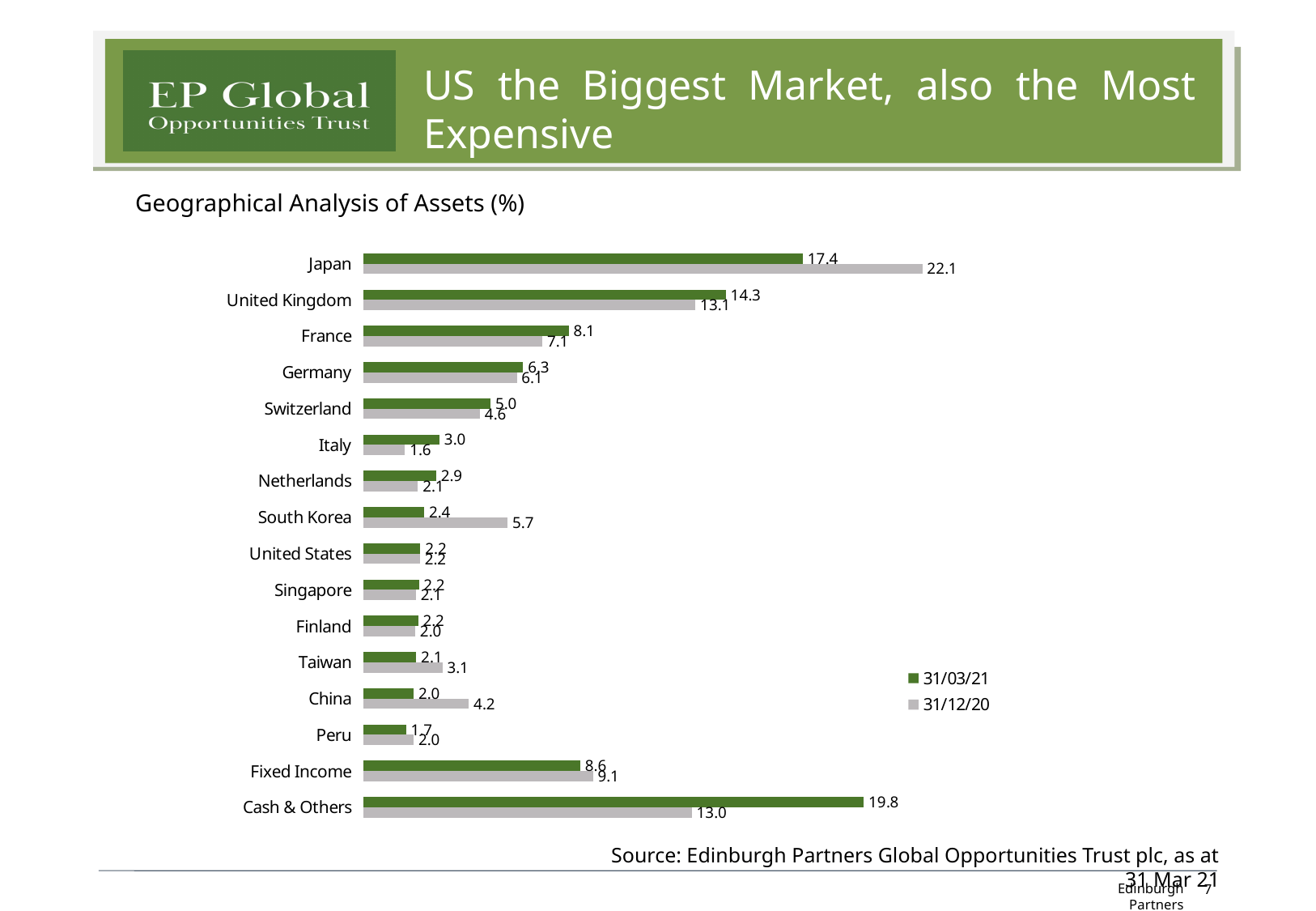
Which category has the lowest value in the 31/12/20 series? Italy Which category has the highest value in the 31/03/21 series? Cash & Others What is the value for Cash & Others in the 31/03/21 series? 19.8 Which is larger for China: the 31/03/21 value or the 31/12/20 value? 31/12/20 What is the title of the chart? Geographical Analysis of Assets (%) What type of chart is shown on the slide? Bar chart How many categories are shown on the chart? 16 Which category has the lowest value in the 31/03/21 series? Peru What is the difference between the 31/12/20 and 31/03/21 values for Japan? 4.7 What is the value for Japan in the 31/12/20 series? 22.1 How many series does the legend list? 2 What is the value for South Korea in the 31/12/20 series? 5.7